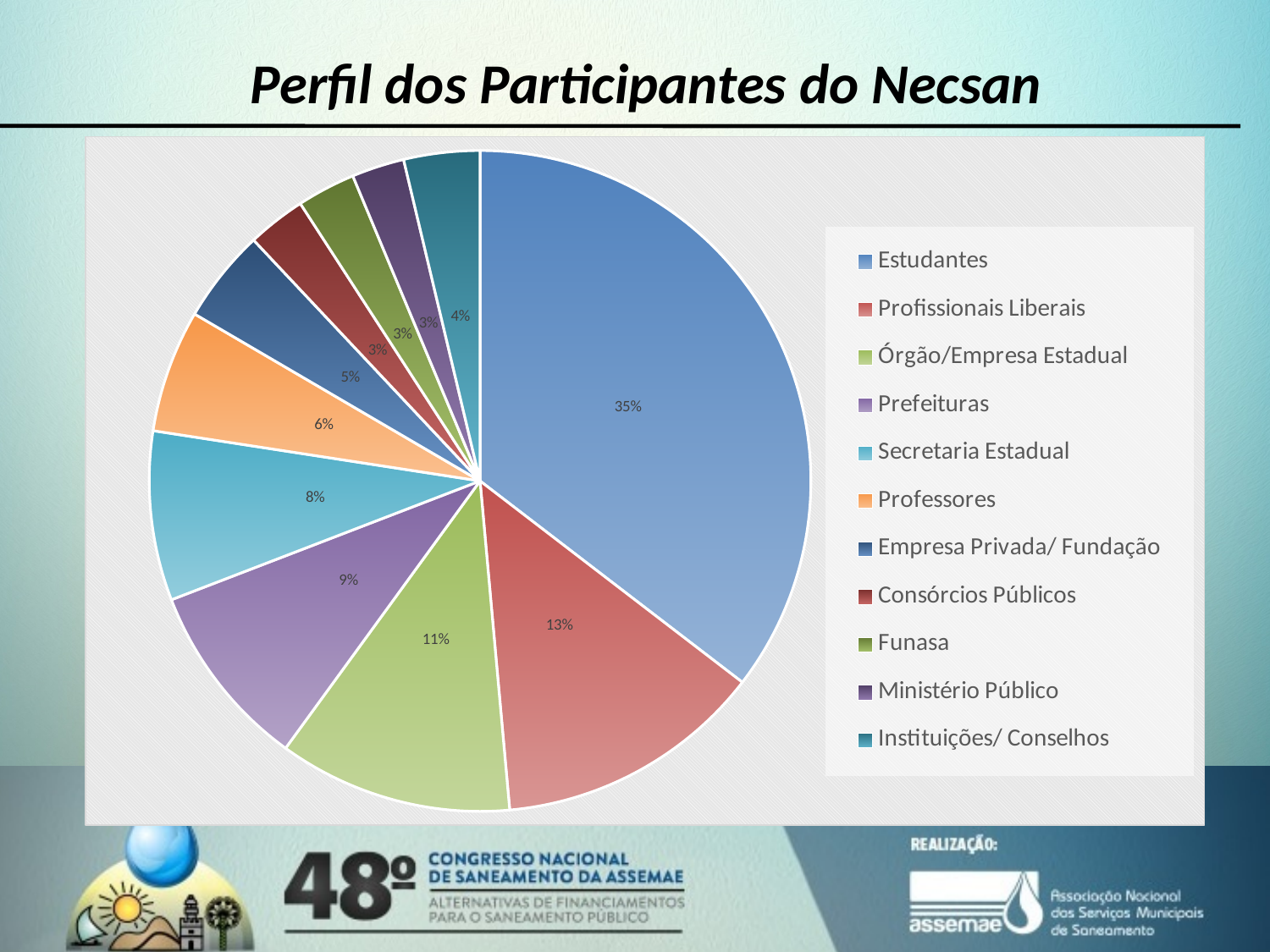
Which is larger, the share for Prefeituras or the share for Professores? Prefeituras What share of the pie is Estudantes? 35% What kind of chart is shown on the slide? pie chart What is the title of the slide's chart? Perfil dos Participantes do Necsan What share of the pie is Secretaria Estadual? 8% What share of the pie is Profissionais Liberais? 13% Which category has the largest share of the pie? Estudantes What is the difference in percentage points between the Estudantes share and the Profissionais Liberais share? 22 How many categories does the legend list? 11